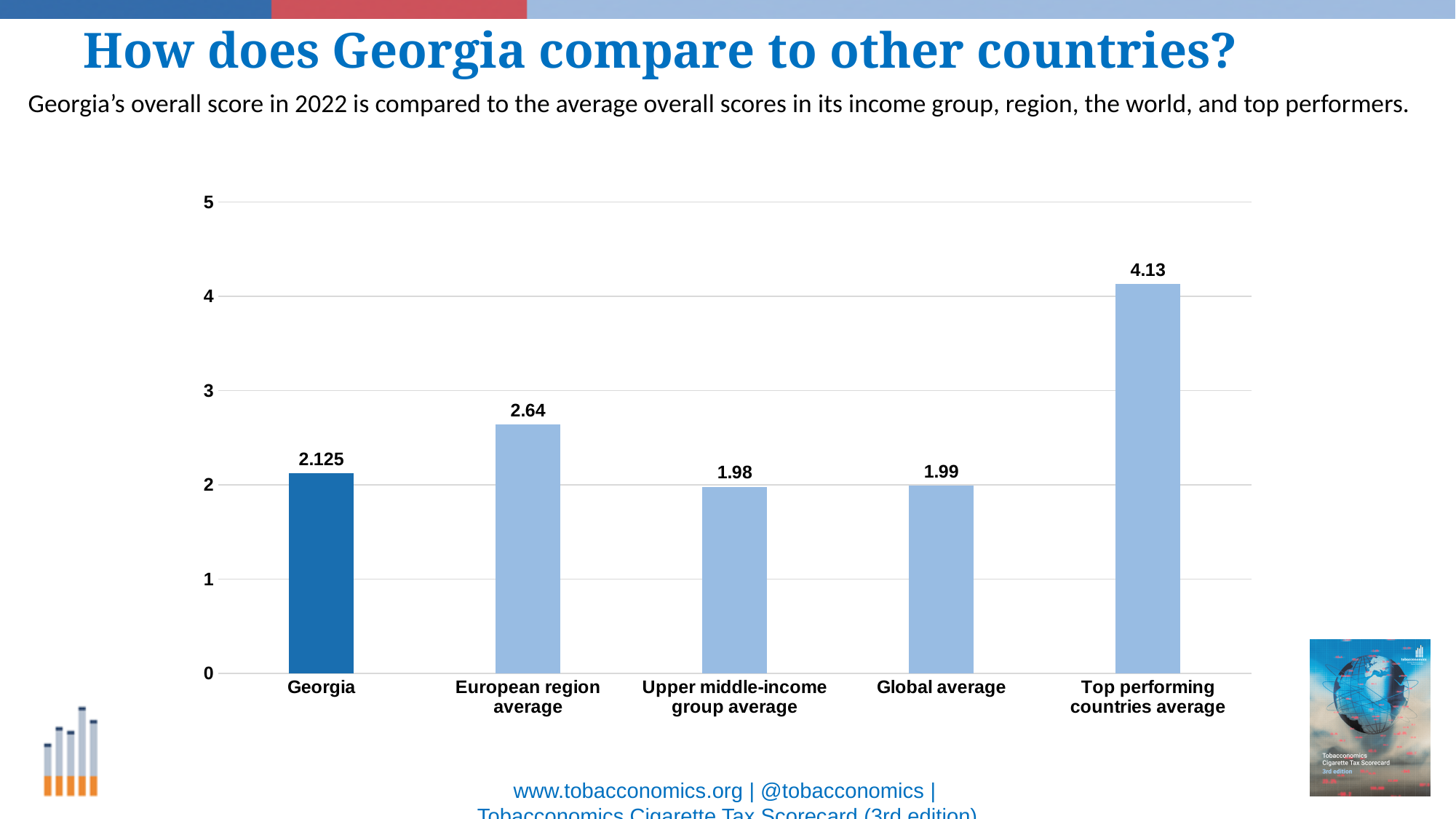
What is the difference between the Top performing countries average and Georgia? 2.005 What kind of chart is shown on the slide? Bar chart Which category has the highest value? Top performing countries average What is the value for the European region average? 2.64 What is the value for Georgia? 2.125 What is the value for the Top performing countries average? 4.13 What is the value for the Upper middle-income group average? 1.98 Which is larger, the value for Georgia or the European region average? European region average How many categories are shown on the chart? 5 Which category has the lowest value? Upper middle-income group average Is the value for the Top performing countries average greater or less than 4? greater What is the difference between the European region average and the Global average? 0.65